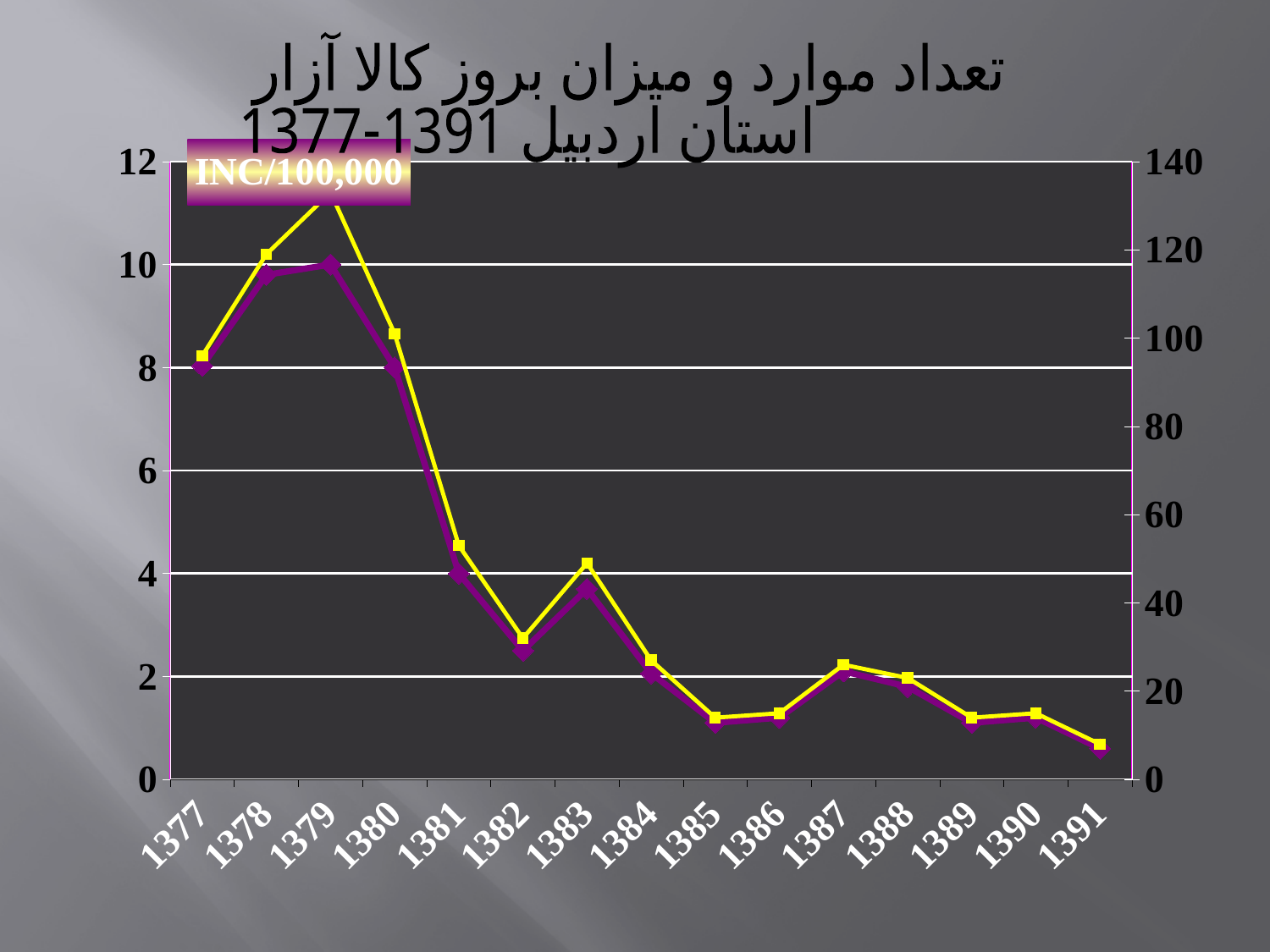
How many lines are plotted on the chart? 2 On the yellow line, is the value for 1378 higher or lower than the value for 1380? higher Overall, do the values on the chart rise or fall from 1377 to 1391? fall In which year does the yellow line reach its highest point? 1379 On the purple line, is the value for 1383 higher or lower than the value for 1382? higher In which year does the purple line reach its highest point? 1379 Reading the purple line against the left axis, is the value for 1381 greater or less than 6? less How many years are shown along the x axis of the chart? 15 What is the highest tick value shown on the right-hand axis of the chart? 140 In which year does the yellow line reach its lowest point? 1391 What text appears in the label box at the top left of the plot area? INC/100,000 What kind of chart is shown on the slide? line chart